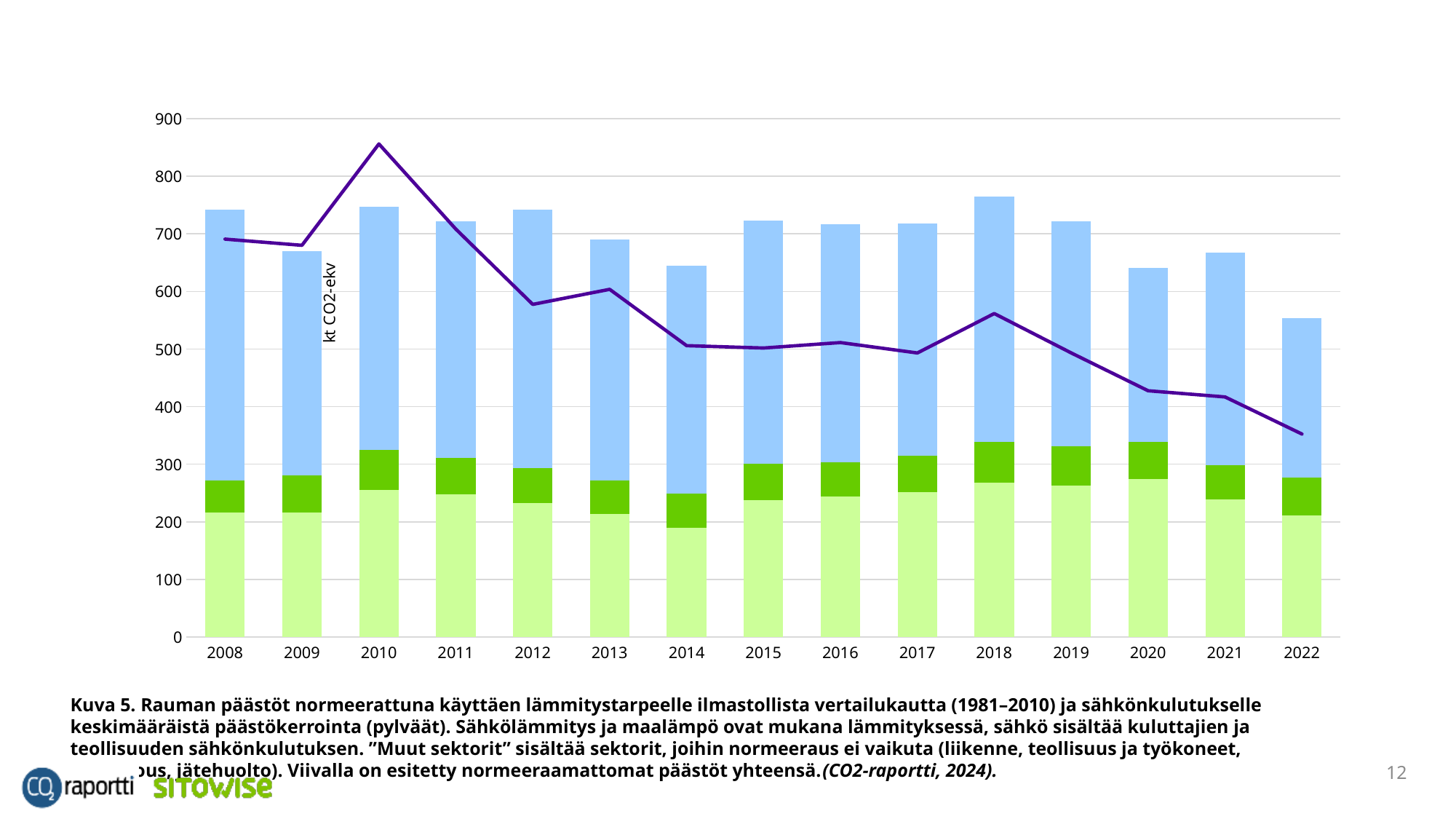
Is the total height of the stacked bar for 2014 greater or less than 600? greater What kind of chart is shown on the slide? Stacked bar chart with a line How many years are shown on the x axis of the chart? 15 Which year has the shortest stacked bar? 2022 In which year does the purple line reach its lowest value? 2022 Is the value of the purple line in 2022 greater or less than 400? less Is the value of the purple line in 2010 greater or less than 800? greater What is the label on the vertical axis of the chart? kt CO2-ekv Which is larger, the stacked bar total for 2018 or for 2022? 2018 Does the purple line rise or fall overall from 2010 to 2022? fall In which year does the purple line reach its highest value? 2010